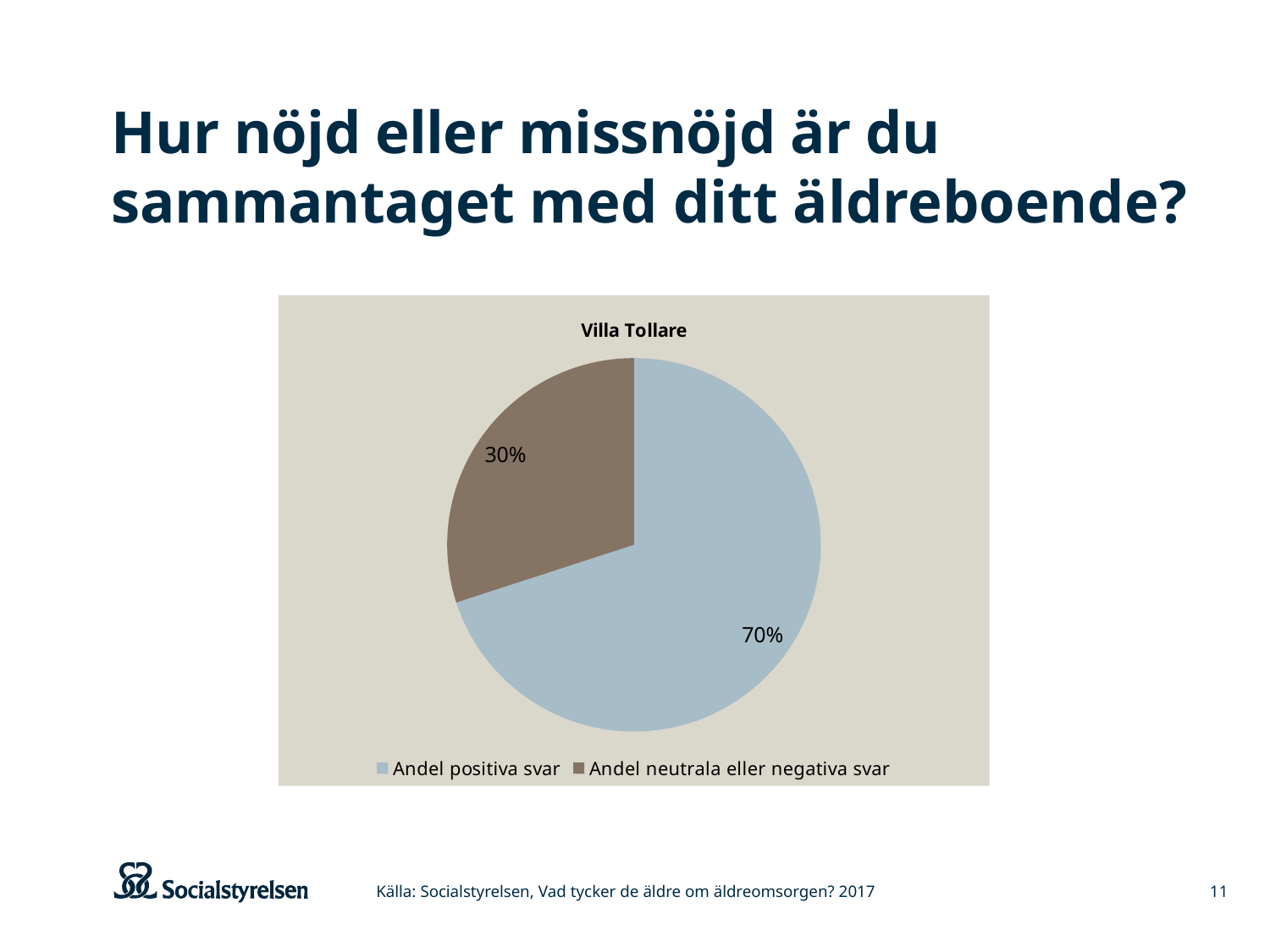
What kind of chart is shown on the slide? pie chart Which slice is the largest? Andel positiva svar How many entries does the legend list? 2 What share of the pie is 'Andel neutrala eller negativa svar'? 30% What colour is the 'Andel neutrala eller negativa svar' slice? brown What is the title of the chart? Villa Tollare Which is larger, 'Andel positiva svar' or 'Andel neutrala eller negativa svar'? Andel positiva svar What share of the pie is 'Andel positiva svar'? 70% Which slice is the smallest? Andel neutrala eller negativa svar Is the value for 'Andel positiva svar' greater or less than 50%? greater How many slices does the pie chart have? 2 What is the difference in percentage points between 'Andel positiva svar' and 'Andel neutrala eller negativa svar'? 40 percentage points